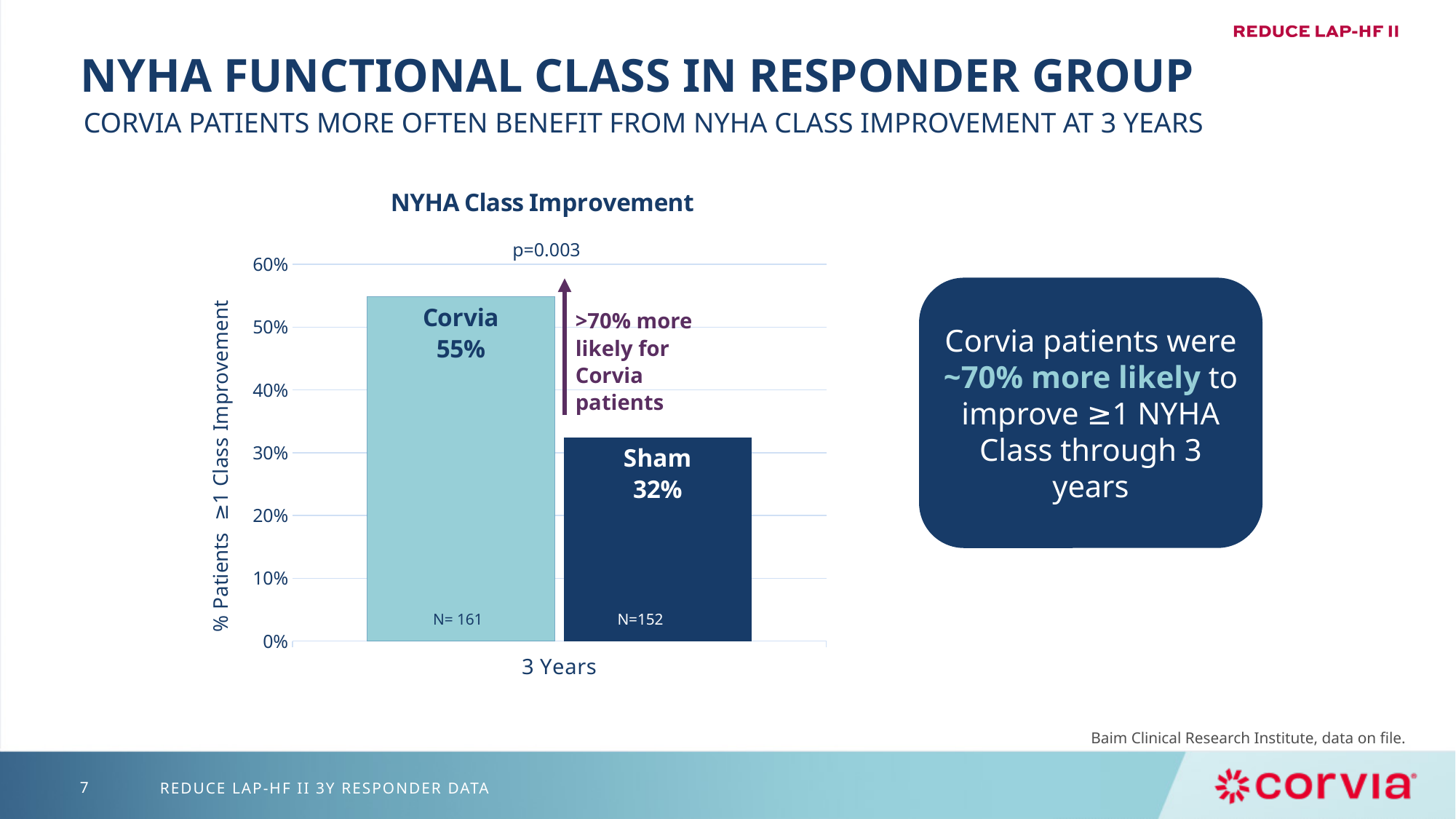
Is the value for Corvia greater or less than 50%? greater What percentage of Corvia patients had a NYHA class improvement at 3 years? 55% Is the Corvia bar larger or smaller than the Sham bar? larger What type of chart is shown on the slide? bar chart Which group has the lower percentage of patients with ≥1 NYHA class improvement? Sham Which group has the higher percentage of patients with ≥1 NYHA class improvement? Corvia What percentage of Sham patients had a NYHA class improvement at 3 years? 32% How many bars are shown in the chart? 2 What p-value is shown above the bars in the chart? p=0.003 What is the title of the chart? NYHA Class Improvement What is the difference in percentage points between the Corvia and Sham bars? 23 percentage points Is the value for Sham greater or less than 40%? less